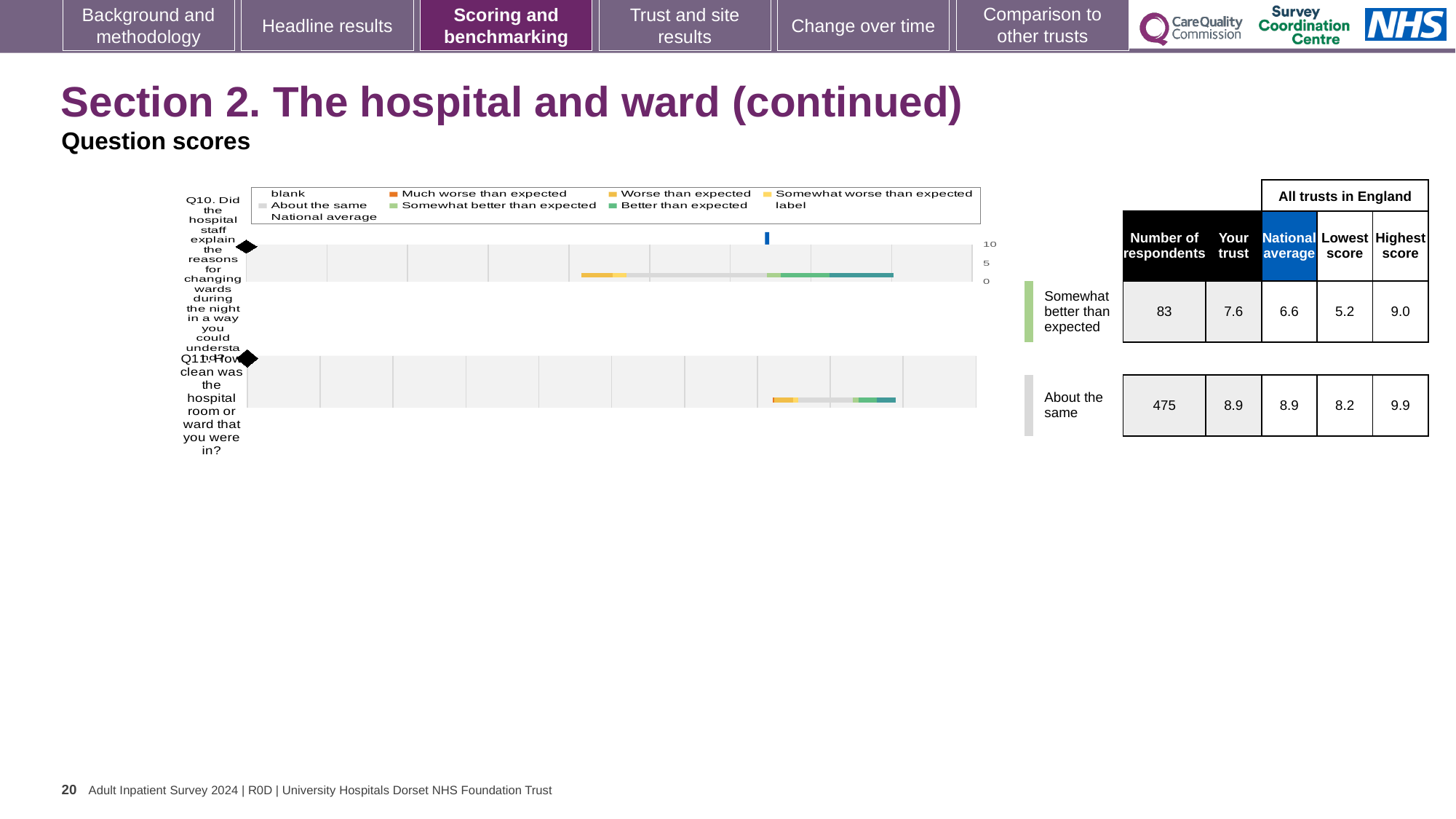
What is the 'Your trust' score for Q10? 7.6 What is the number of respondents for Q10 (explaining reasons for changing wards during the night)? 83 What is the difference between the highest score (9.0) and the lowest score (5.2) for Q10? 3.8 What kind of chart is used to show the question scores on this slide? bar chart What benchmark category is shown for Q11? About the same How many questions are plotted in the chart on this slide? 2 What is the highest score among all trusts in England for Q11? 9.9 What is the national average score for Q10? 6.6 For Q10, which is larger: the 'Your trust' score or the national average? Your trust Which question has more respondents, Q10 or Q11? Q11 What is the number of respondents for Q11 (how clean was the hospital room or ward)? 475 What is the lowest score among all trusts in England for Q10? 5.2